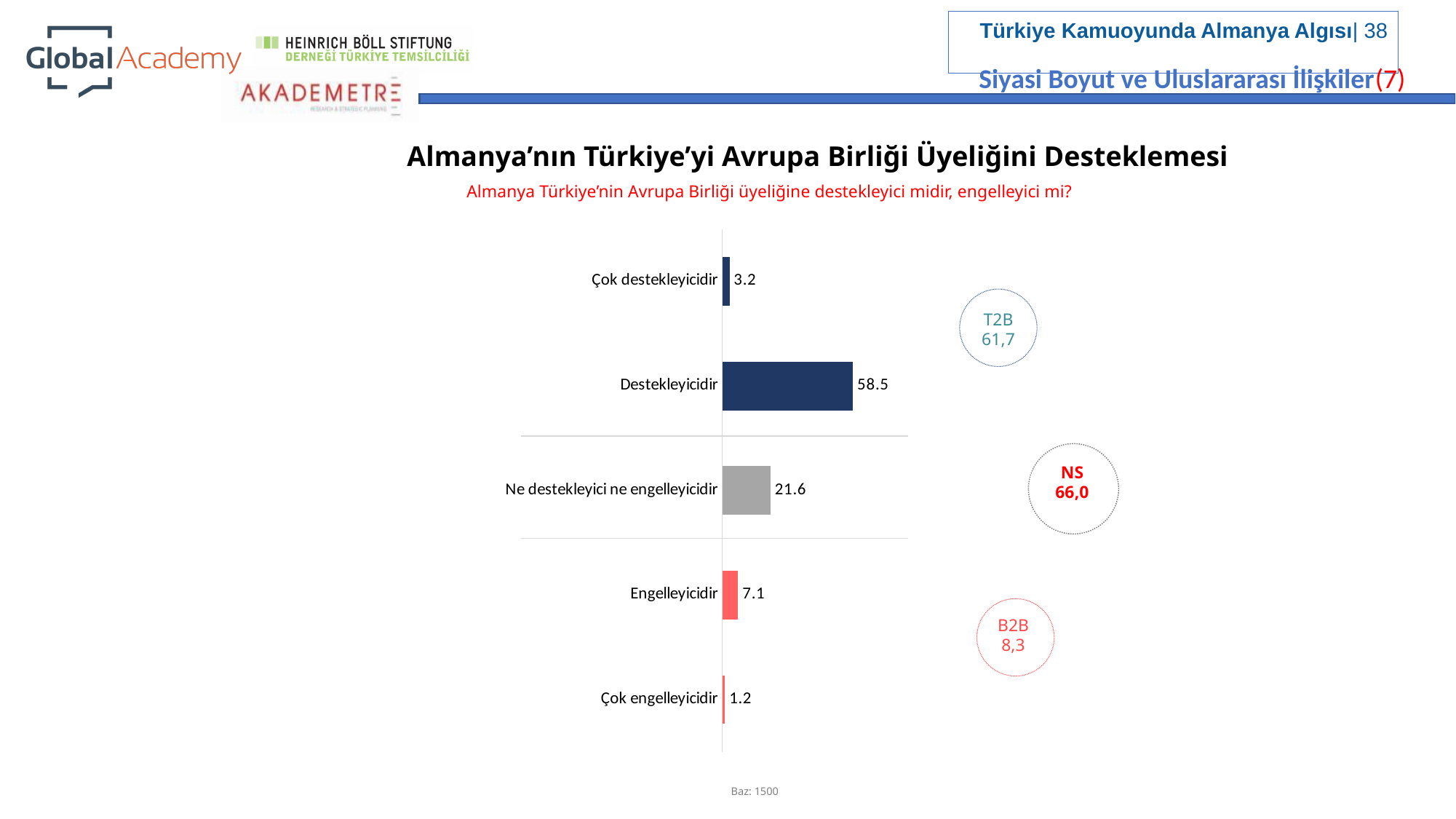
What is the T2B value shown in the circle next to the chart? 61,7 What is the value for "Engelleyicidir"? 7.1 Which category has the highest value? Destekleyicidir What kind of chart is shown on the slide? Bar chart What is the value for "Çok engelleyicidir"? 1.2 Which is larger, the value for "Çok destekleyicidir" or the value for "Engelleyicidir"? Engelleyicidir Which category has the lowest value? Çok engelleyicidir How many categories are shown in the chart? 5 What is the value for "Ne destekleyici ne engelleyicidir"? 21.6 What is the base (Baz) sample size noted below the chart? 1500 What is the value for "Destekleyicidir"? 58.5 What is the difference between the values for "Destekleyicidir" and "Ne destekleyici ne engelleyicidir"? 36.9